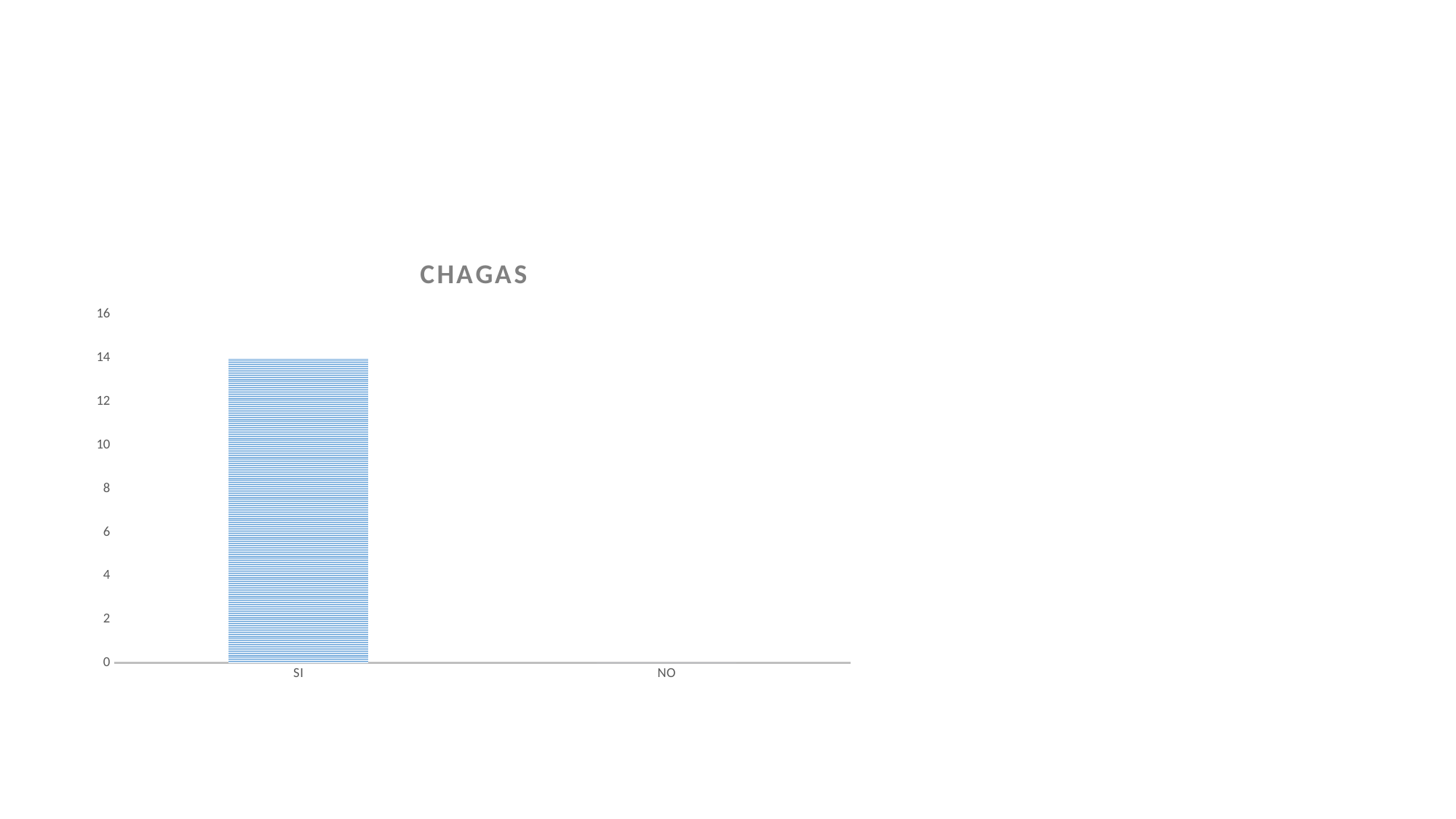
What is the value for SI in the CHAGAS chart? 14 What is the value for NO in the CHAGAS chart? 0 What is the highest value shown on the y axis of the CHAGAS chart? 16 Which category has the highest value in the CHAGAS chart? SI Which category has the lowest value in the CHAGAS chart? NO What is the difference between the values for SI and NO in the CHAGAS chart? 14 What kind of chart is shown on the slide? bar chart What is the title of the chart? CHAGAS Which is larger in the CHAGAS chart, SI or NO? SI Is the value for SI greater or less than 10? greater How many categories are shown on the x axis of the CHAGAS chart? 2 Do the values rise or fall from SI to NO along the x axis? fall